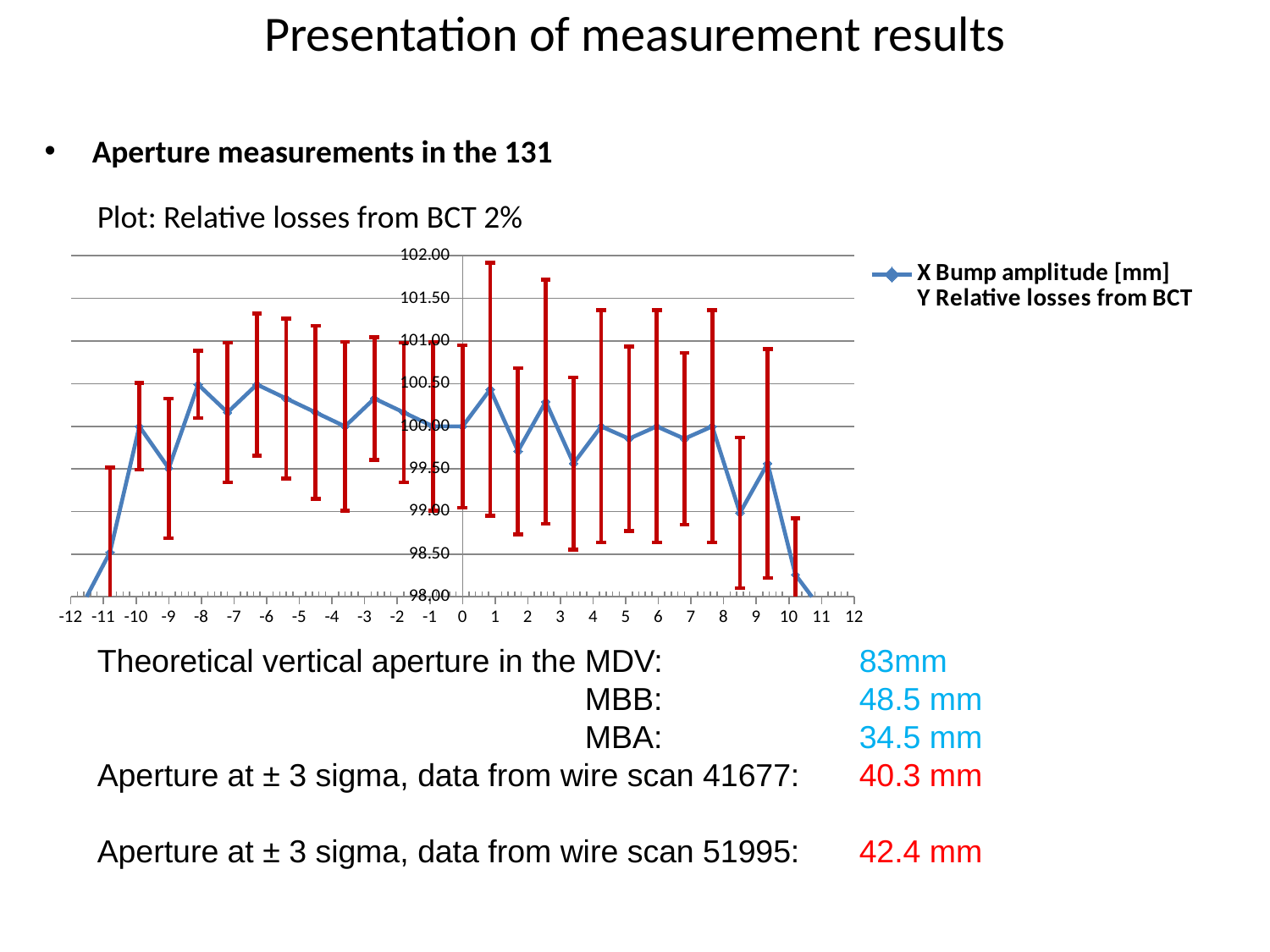
What is the legend entry for the plotted series? X Bump amplitude [mm] Y Relative losses from BCT Is the value for x = -9 greater or less than 100.00? less What is the highest value shown on the chart's vertical axis? 102.00 What kind of chart is shown on the slide? line chart Do the plotted values rise or fall between x = -12 and x = -8? rise Do the plotted values rise or fall between x = 8 and x = 11? fall Is the value for x = 10 greater or less than 99.00? less Is the value for x = -11 greater or less than 99.00? less How many series does the chart legend list? 1